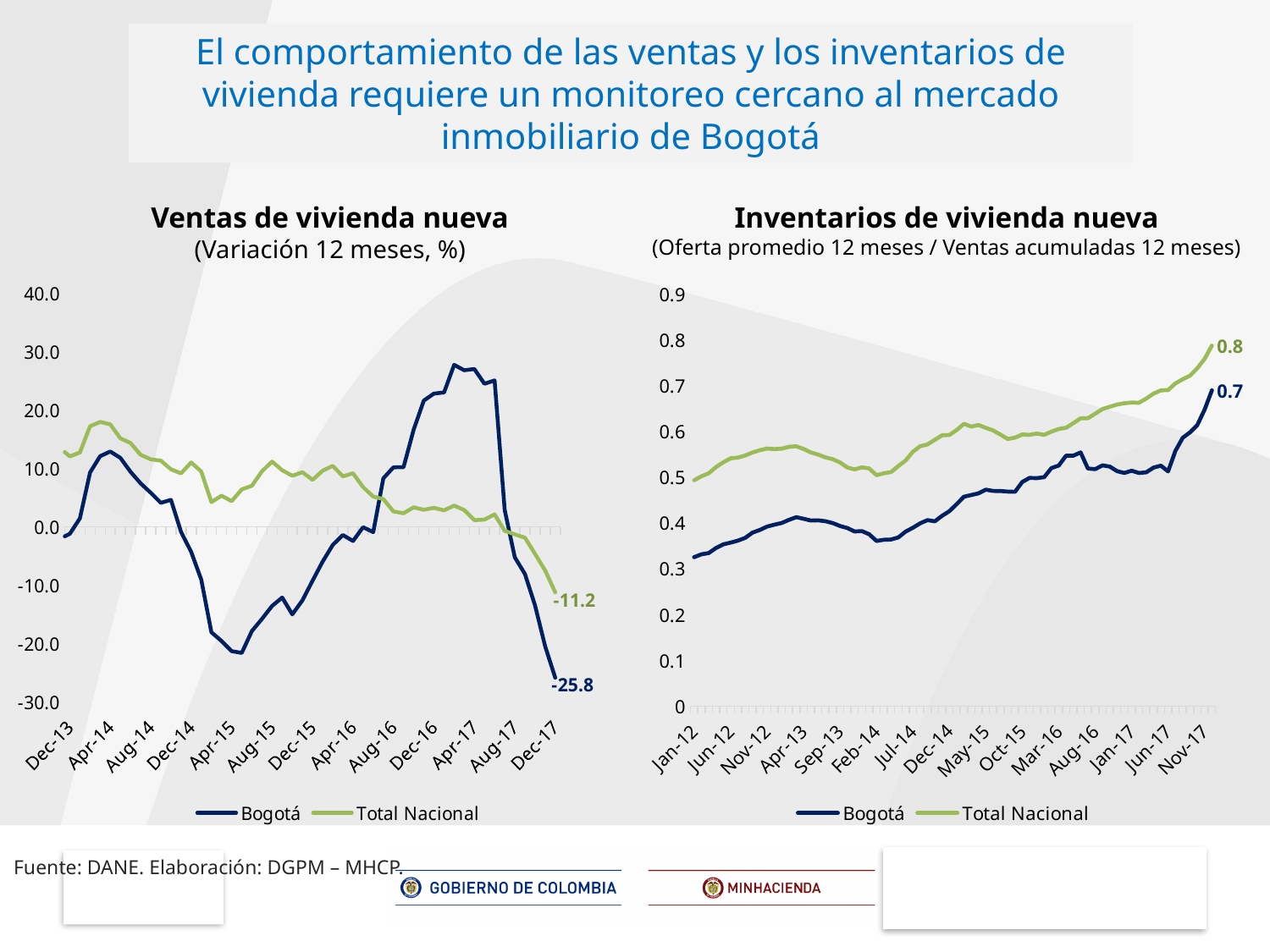
In the 'Inventarios de vivienda nueva' chart, what is the labelled value for Total Nacional at Nov-17? 0.8 How many series does the legend of the 'Inventarios de vivienda nueva' chart list? 2 In the 'Ventas de vivienda nueva' chart, what is the difference between the Total Nacional and Bogotá labelled values at Dec-17? 14.6 In the 'Ventas de vivienda nueva' chart, which series has the lower value at Dec-17, Bogotá or Total Nacional? Bogotá In the 'Inventarios de vivienda nueva' chart, which series has the higher value at Nov-17, Bogotá or Total Nacional? Total Nacional In the 'Inventarios de vivienda nueva' chart, what is the labelled value for Bogotá at Nov-17? 0.7 What kind of chart is the 'Ventas de vivienda nueva' chart? Line chart In the 'Ventas de vivienda nueva' chart, what is the labelled value for Bogotá at Dec-17? -25.8 What is the subtitle shown under the 'Ventas de vivienda nueva' chart title? (Variación 12 meses, %) In the 'Ventas de vivienda nueva' chart, what is the labelled value for Total Nacional at Dec-17? -11.2 In the 'Inventarios de vivienda nueva' chart, does the Total Nacional series generally rise or fall from Jan-12 to Nov-17? Rise In the 'Inventarios de vivienda nueva' chart, is the value for Bogotá at Jan-12 greater or less than 0.4? less